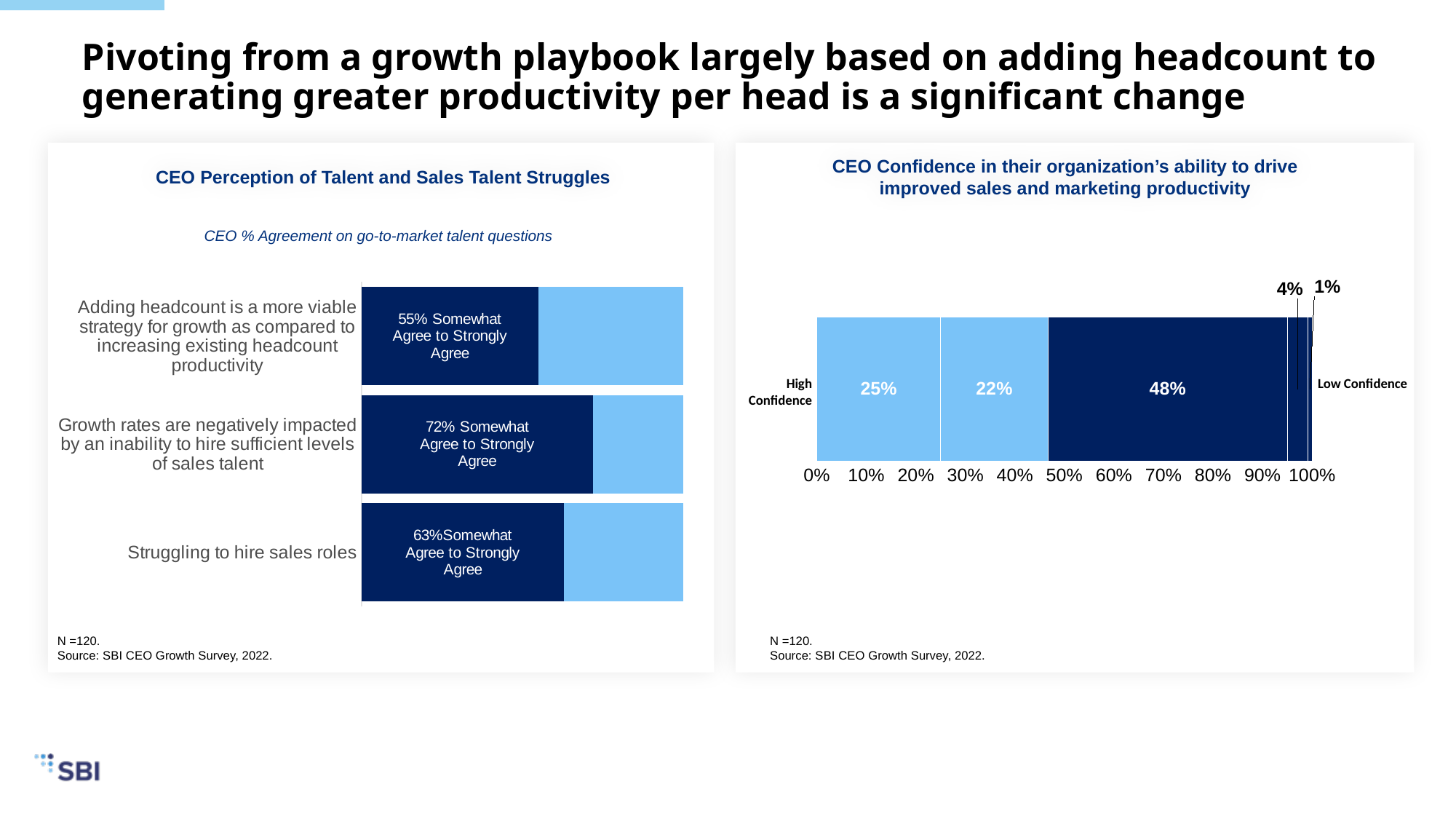
In the right chart on CEO Confidence, how many segments make up the stacked bar? 5 In the right chart on CEO Confidence, what is the value of the smallest segment, at the Low Confidence end? 1% In the right chart on CEO Confidence, what is the difference in percentage points between the 25% segment and the 22% segment? 3 percentage points How many statements are plotted in the chart titled 'CEO Perception of Talent and Sales Talent Struggles'? 3 In the chart titled 'CEO Perception of Talent and Sales Talent Struggles', what percentage of CEOs agree that adding headcount is a more viable strategy for growth as compared to increasing existing headcount productivity? 55% In the left chart, which statement has the highest percentage of CEO agreement? Growth rates are negatively impacted by an inability to hire sufficient levels of sales talent In the chart titled 'CEO Perception of Talent and Sales Talent Struggles', what percentage of CEOs somewhat agree to strongly agree that growth rates are negatively impacted by an inability to hire sufficient levels of sales talent? 72% In the right chart on CEO Confidence, what is the value of the largest segment of the bar? 48% In the left chart, which statement has the lowest percentage of CEO agreement? Adding headcount is a more viable strategy for growth as compared to increasing existing headcount productivity In the left chart, what is the difference in percentage points between agreement on 'Growth rates are negatively impacted by an inability to hire sufficient levels of sales talent' and 'Struggling to hire sales roles'? 9 percentage points What type of chart is the 'CEO Perception of Talent and Sales Talent Struggles' chart? Bar chart In the right chart on CEO Confidence, what is the total of all the segments in the stacked bar? 100%